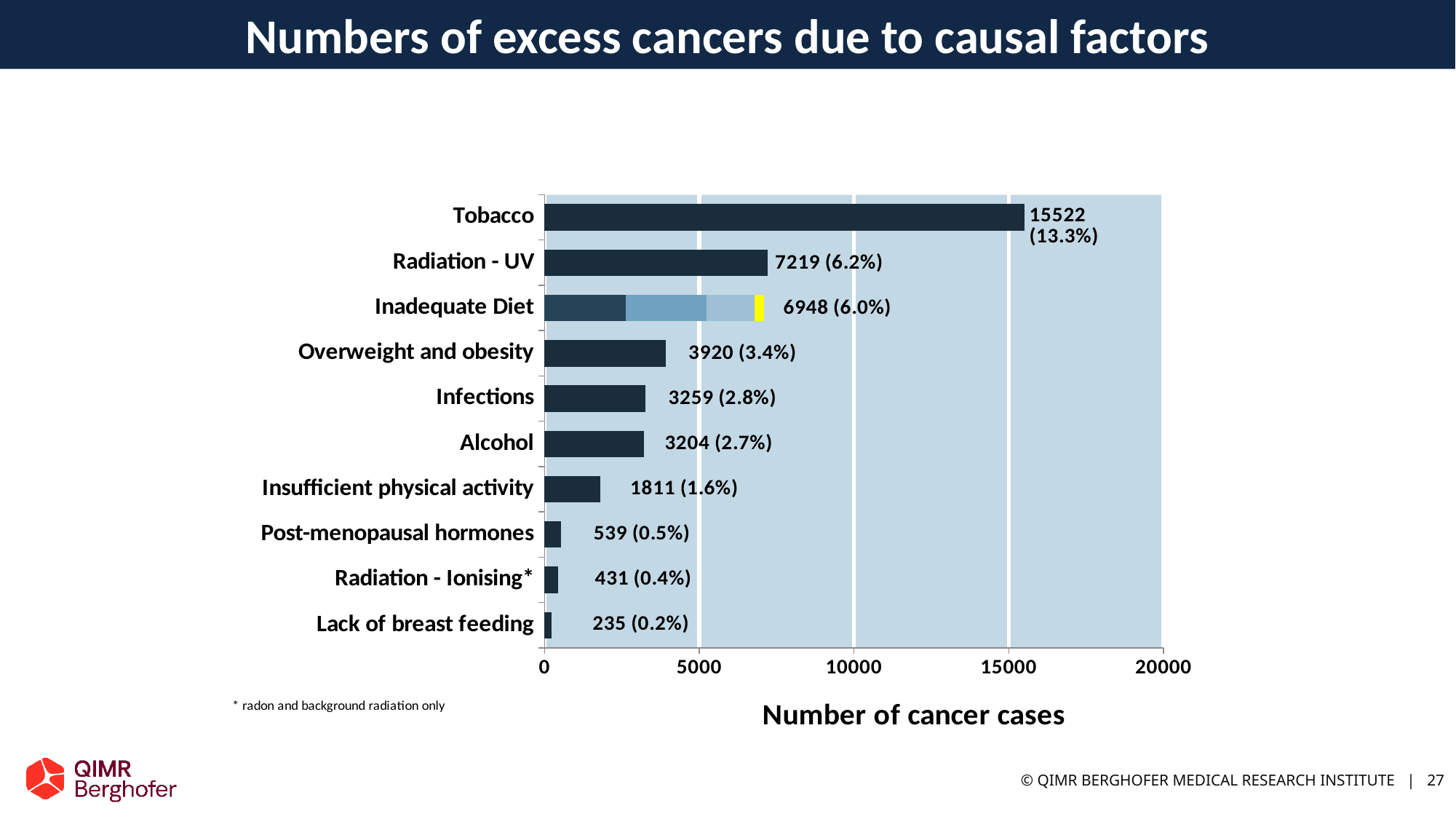
Which causal factor accounts for the lowest number of excess cancer cases? Lack of breast feeding What is the difference in excess cancer cases between Tobacco and Radiation - UV? 8303 Which has more excess cancer cases, Radiation - UV or Inadequate Diet? Radiation - UV What is the number of excess cancer cases attributed to Alcohol? 3204 (2.7%) How many causal factors are shown on the chart? 10 What is the difference in excess cancer cases between Overweight and obesity and Infections? 661 What is the number of excess cancer cases attributed to Lack of breast feeding? 235 (0.2%) What is the number of excess cancer cases attributed to Tobacco? 15522 (13.3%) What is the label of the horizontal axis? Number of cancer cases Which causal factor accounts for the highest number of excess cancer cases? Tobacco Is the value for Overweight and obesity greater or less than 5000? less What type of chart is shown on the slide? bar chart